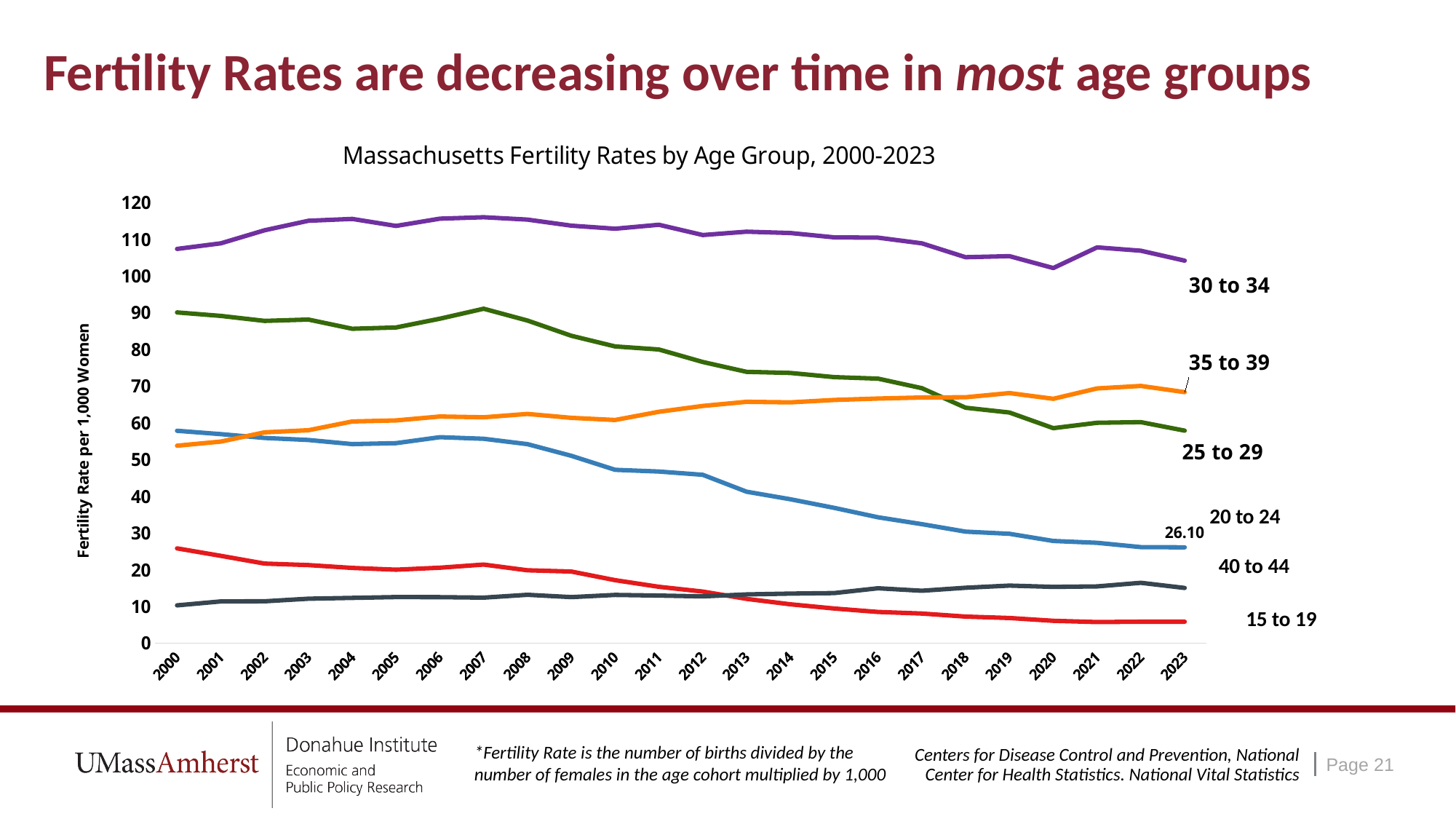
In 2023, which age group has the higher fertility rate: 35 to 39 or 25 to 29? 35 to 39 What is the title of the chart? Massachusetts Fertility Rates by Age Group, 2000-2023 How many age-group series are plotted on the chart? 6 Which age group has the highest fertility rate in 2023? 30 to 34 Does the fertility rate for the 15 to 19 age group rise or fall from 2000 to 2023? fall How many years are shown on the x axis of the chart? 24 What is the fertility rate for the 20 to 24 age group in 2023? 26.10 Which age group has the lowest fertility rate in 2023? 15 to 19 Does the fertility rate for the 35 to 39 age group rise or fall from 2000 to 2023? rise Is the fertility rate for the 30 to 34 age group in 2000 greater or less than 100? greater What kind of chart is shown on the slide? line chart Is the fertility rate for the 15 to 19 age group in 2023 greater or less than 10? less